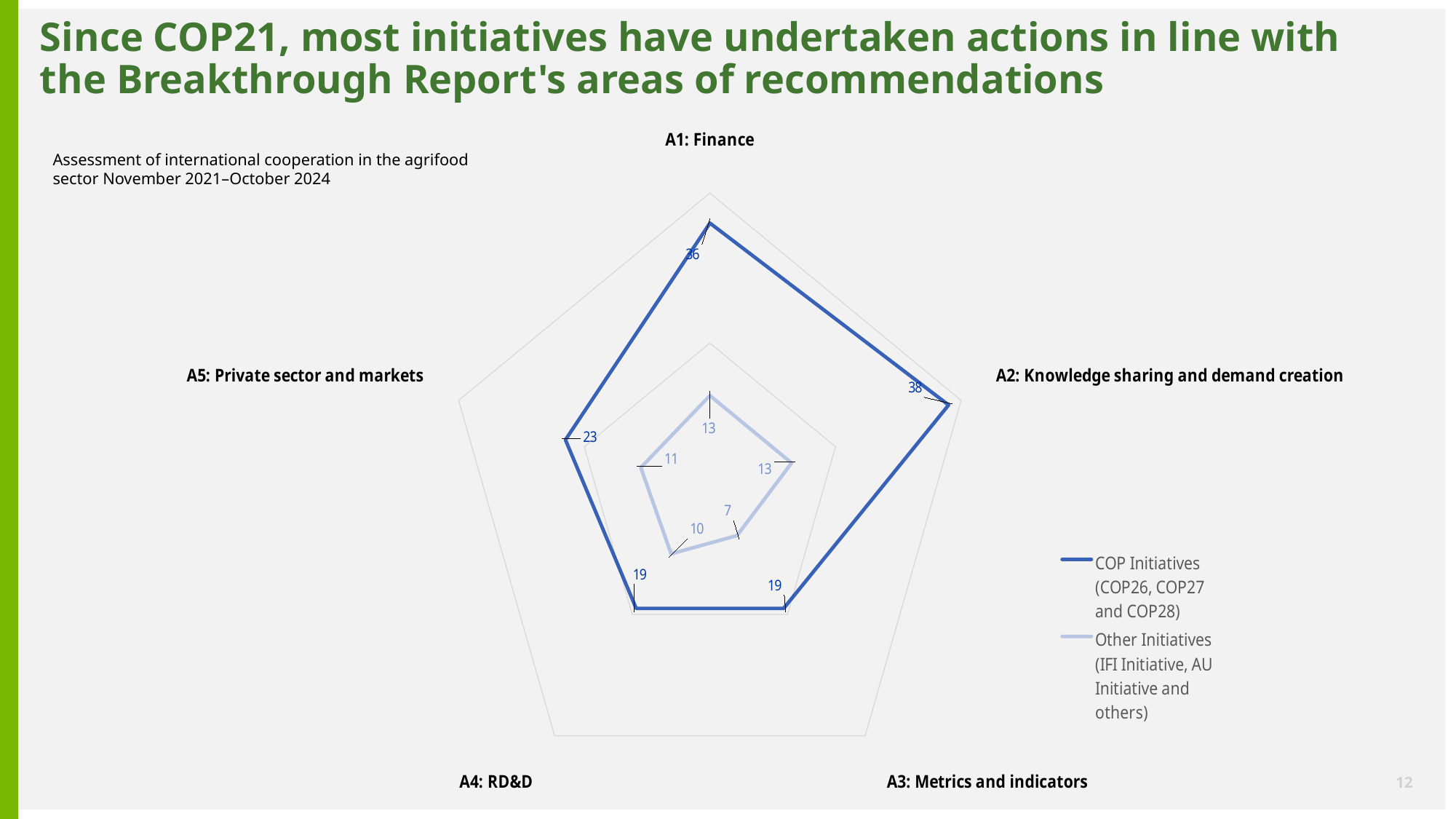
How many series does the legend list? 2 What is the value for Other Initiatives on A3: Metrics and indicators? 7 How many categories (axes) does the radar chart have? 5 Which is larger: the COP Initiatives value on A5: Private sector and markets or the COP Initiatives value on A4: RD&D? A5: Private sector and markets On which category does the COP Initiatives series have its highest value? A2: Knowledge sharing and demand creation What is the value for COP Initiatives on A1: Finance? 36 What is the value for Other Initiatives on A5: Private sector and markets? 11 What kind of chart is shown on the slide? Radar chart What is the difference between the COP Initiatives value and the Other Initiatives value on A1: Finance? 23 What is the value for COP Initiatives on A2: Knowledge sharing and demand creation? 38 Which series is drawn with the darker blue line? COP Initiatives (COP26, COP27 and COP28) On which category does the Other Initiatives series have its lowest value? A3: Metrics and indicators